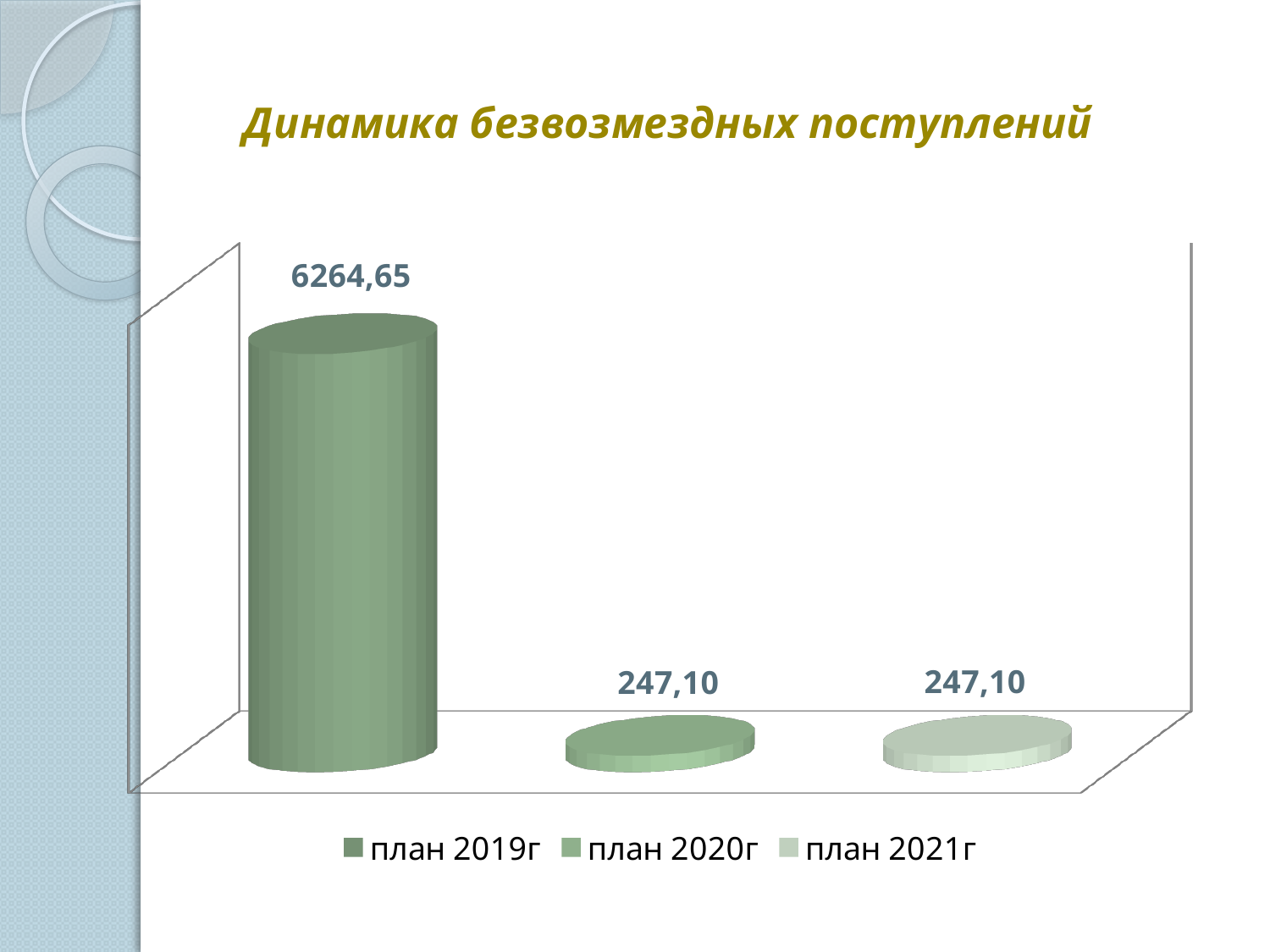
What is the title of the chart? Динамика безвозмездных поступлений What is the value for план 2021г? 247,10 Which series has the highest value? план 2019г What is the value for план 2020г? 247,10 What is the value for план 2019г? 6264,65 Are the values for план 2020г and план 2021г the same or different? the same What is the difference between the values for план 2019г and план 2020г? 6017,55 What kind of chart is shown on the slide? bar chart Do the values rise or fall from план 2019г to план 2020г? fall Which is larger, the value for план 2019г or the value for план 2021г? план 2019г How many series does the legend list? 3 How many bars are plotted on the chart? 3